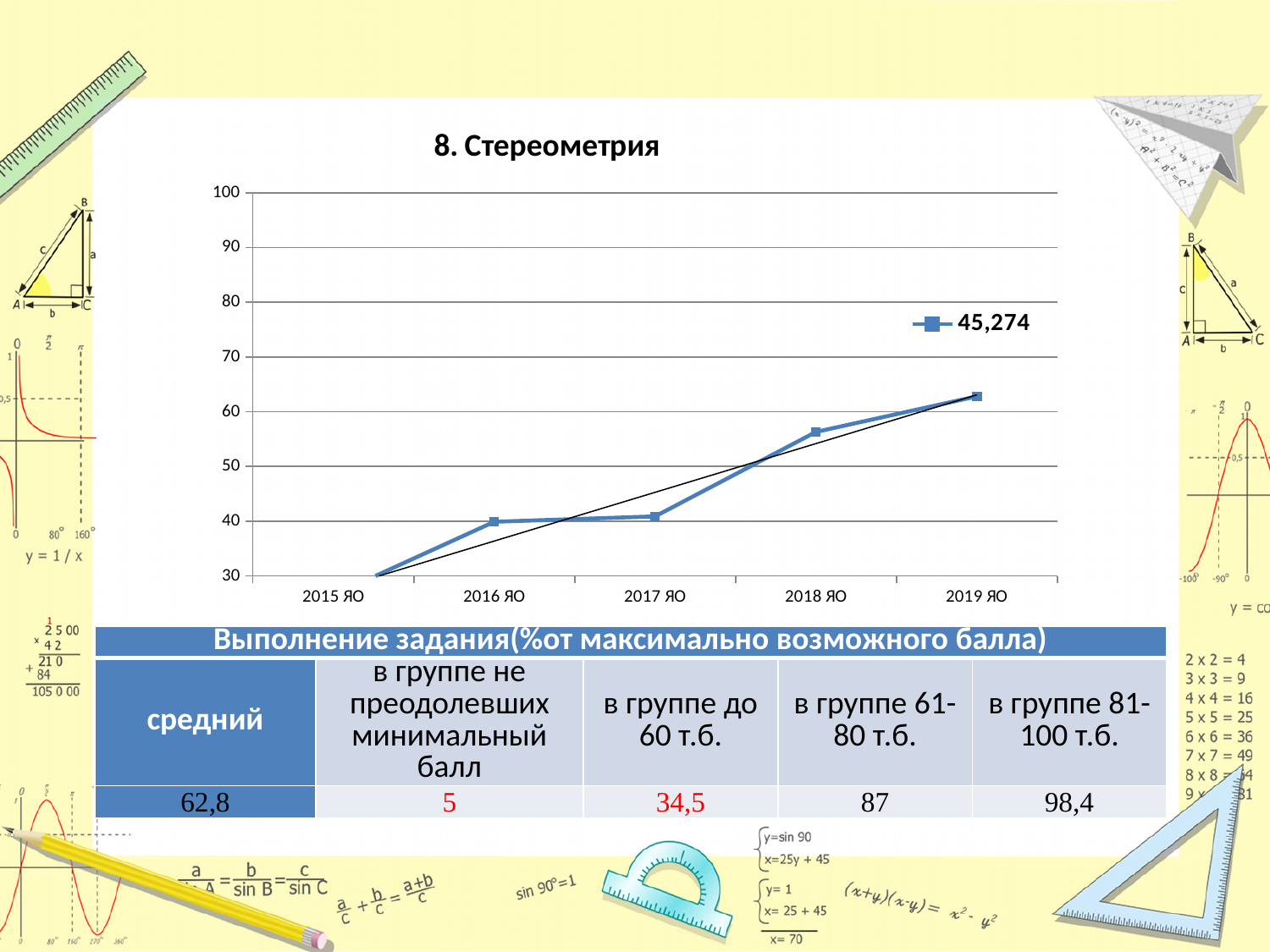
Do the values rise or fall from 2015 ЯО to 2019 ЯО? rise Is the value for 2019 ЯО greater or less than 60? greater Is the value for 2018 ЯО greater or less than 50? greater Which is larger, the value for 2016 ЯО or the value for 2018 ЯО? 2018 ЯО How many data points are plotted along the x axis of the chart? 5 How many series does the chart legend list? 1 What is the legend entry shown for the plotted series? 45,274 Is the value for 2017 ЯО greater or less than 50? less Which year has the lowest value on the chart? 2015 ЯО Which year has the highest value on the chart? 2019 ЯО What is the title of the chart? 8. Стереометрия What kind of chart is shown on the slide? line chart